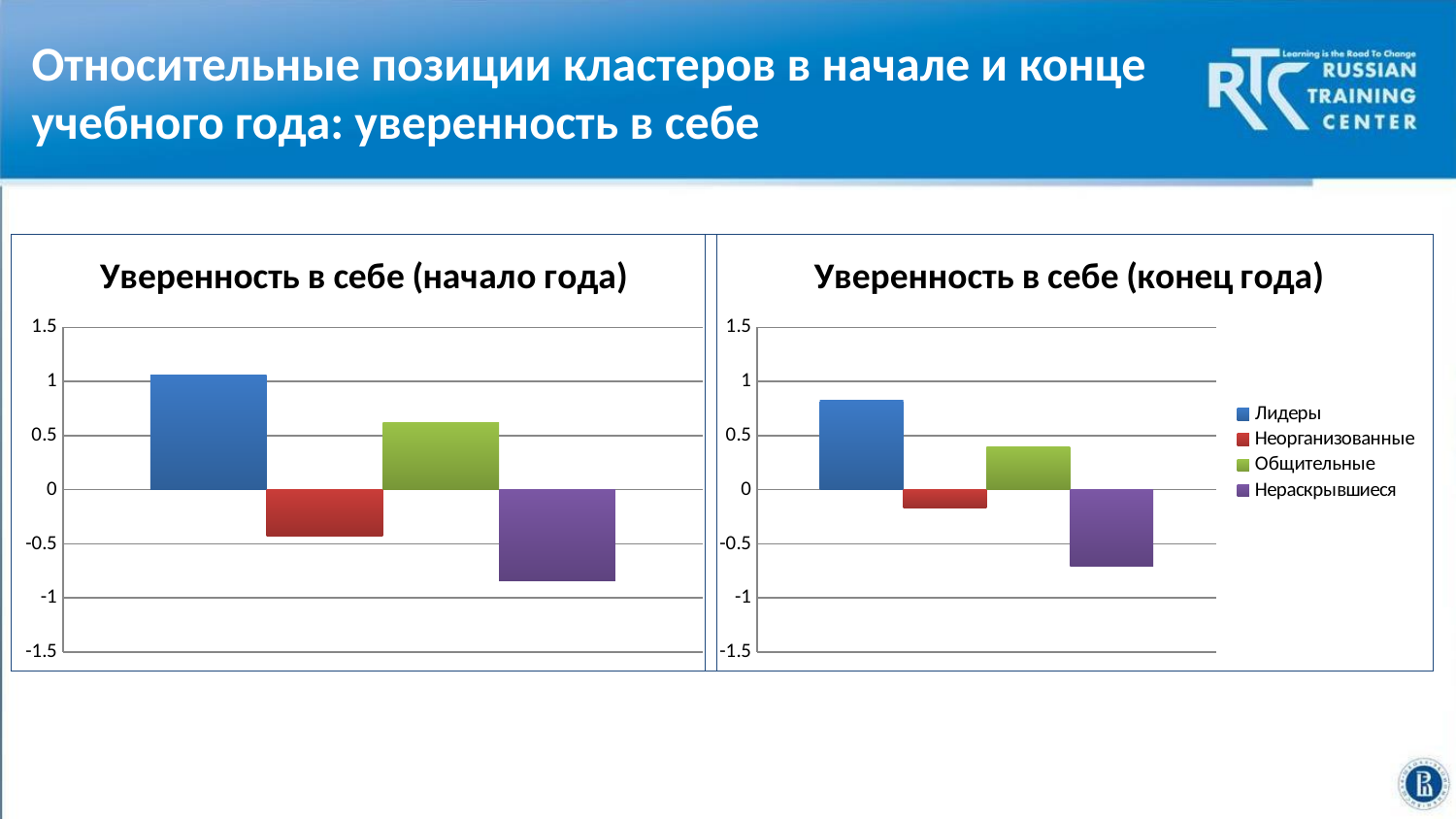
In the chart "Уверенность в себе (начало года)", which series has the lowest value? Нераскрывшиеся What kind of chart is "Уверенность в себе (начало года)"? bar chart In the chart "Уверенность в себе (конец года)", is the value for Лидеры greater or less than 1? less In the chart "Уверенность в себе (конец года)", which series has the lowest value? Нераскрывшиеся In the chart "Уверенность в себе (начало года)", is the value for Лидеры greater or less than 1? greater In the chart "Уверенность в себе (конец года)", which is larger, the value for Лидеры or the value for Общительные? Лидеры In the chart "Уверенность в себе (начало года)", which series has the highest value? Лидеры How many series does the legend list on the slide? 4 In the chart "Уверенность в себе (конец года)", which series has the highest value? Лидеры In the chart "Уверенность в себе (конец года)", is the value for Неорганизованные greater or less than -0.5? greater Which colour represents the series Общительные in the legend? green